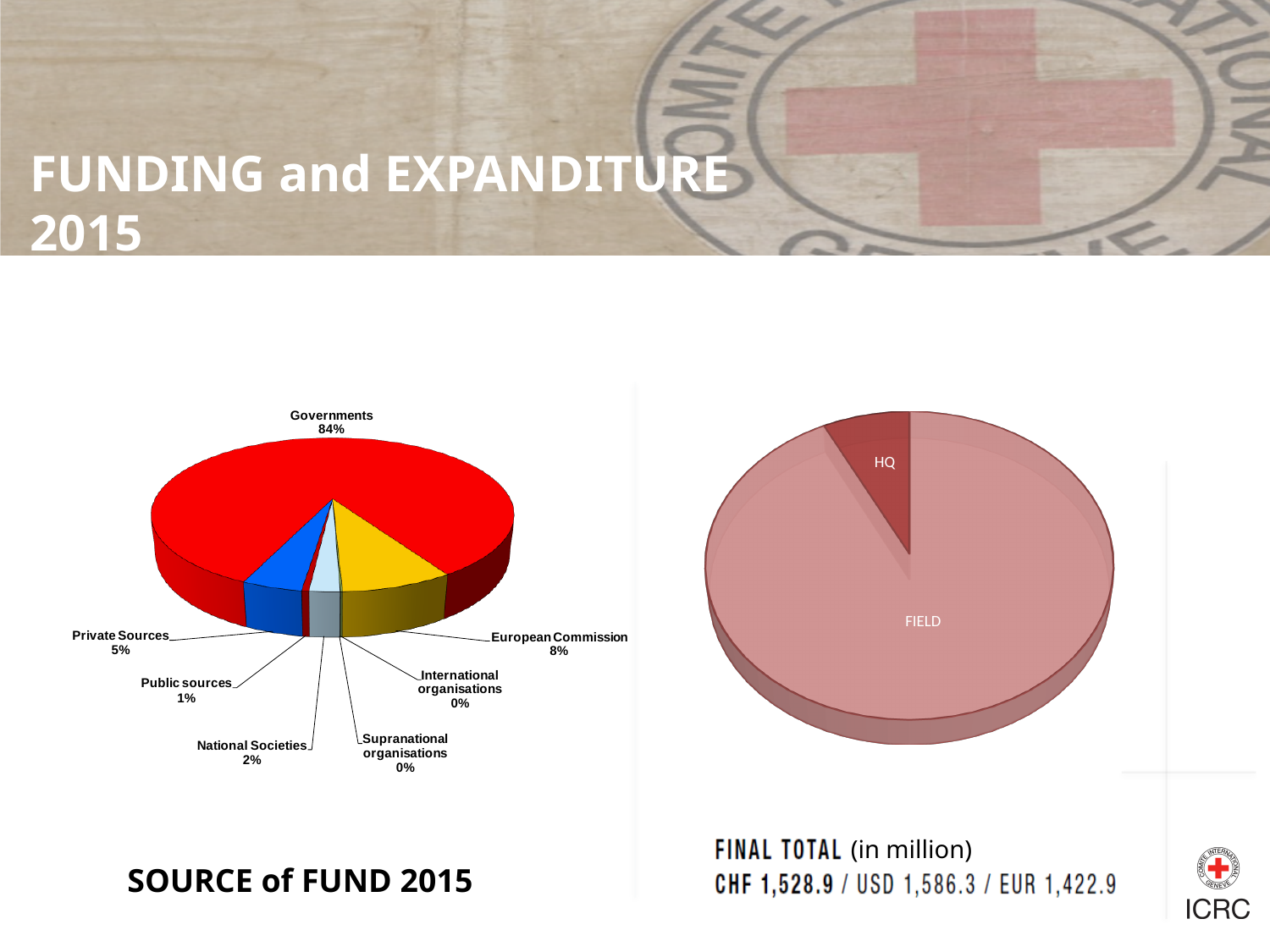
In the SOURCE of FUND 2015 pie chart, what percentage comes from National Societies? 2% In the SOURCE of FUND 2015 pie chart, which is larger: Private Sources or Public sources? Private Sources In the SOURCE of FUND 2015 pie chart, what percentage is attributed to the European Commission? 8% In the SOURCE of FUND 2015 pie chart, what share comes from Private Sources? 5% What type of chart is the SOURCE of FUND 2015 chart? Pie chart In the SOURCE of FUND 2015 pie chart, what share of funding comes from Governments? 84% In the SOURCE of FUND 2015 pie chart, which source has the largest share? Governments How many funding sources are labelled in the SOURCE of FUND 2015 pie chart? 7 In the pie chart on the right of the slide, which slice is larger: HQ or FIELD? FIELD How many slices does the pie chart on the right of the slide have? 2 In the SOURCE of FUND 2015 pie chart, what is the difference in percentage points between Governments and the European Commission? 76 In the SOURCE of FUND 2015 pie chart, what colour is the Governments slice? Red